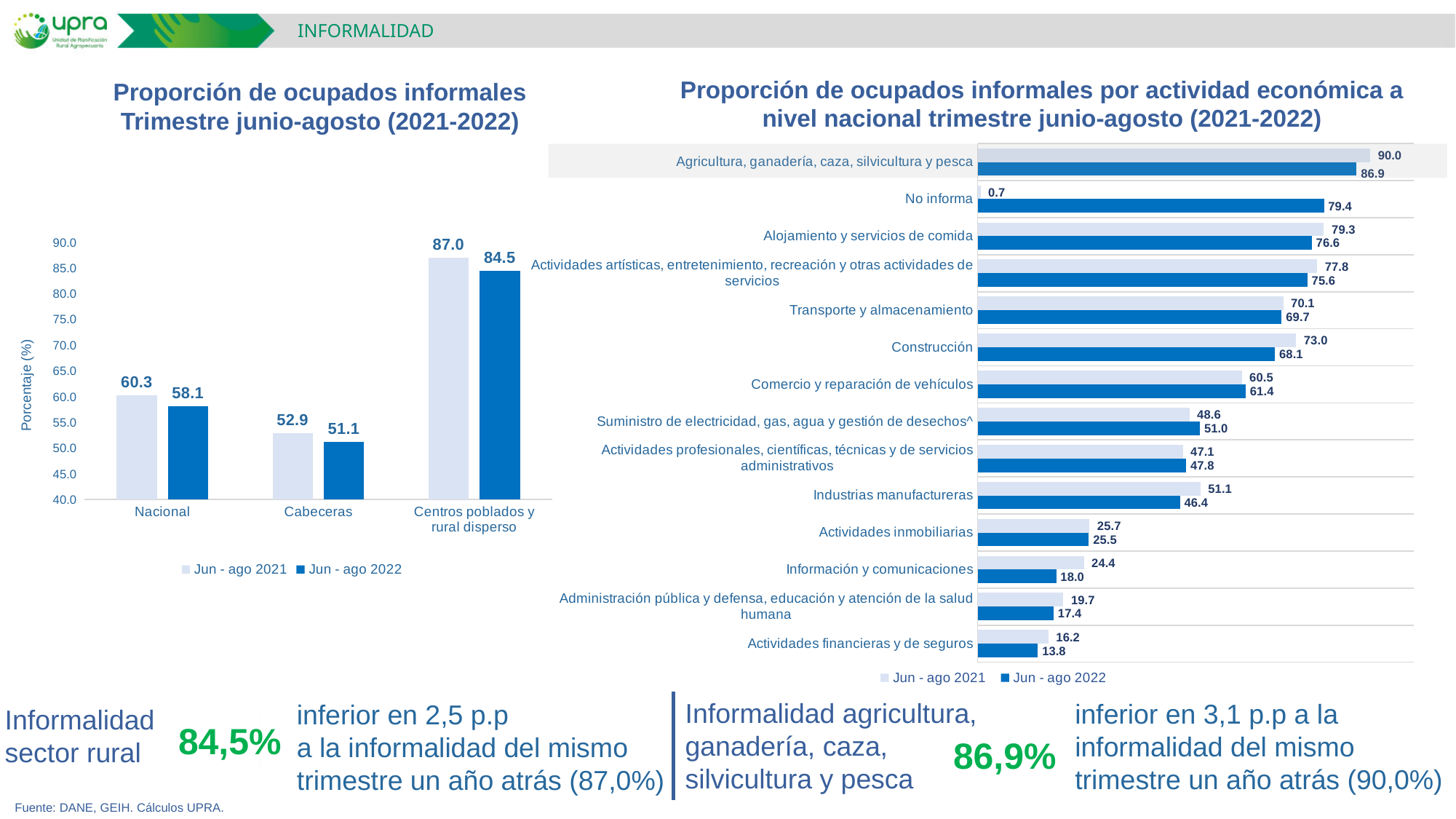
In the left chart (Proporción de ocupados informales, Trimestre junio-agosto), what is the difference between the Jun - ago 2021 and Jun - ago 2022 values for Centros poblados y rural disperso? 2.5 In the left chart (Proporción de ocupados informales, Trimestre junio-agosto), what type of chart is it? Bar chart In the right chart (Proporción de ocupados informales por actividad económica), which activity has the lowest Jun - ago 2022 value? Actividades financieras y de seguros In the right chart (Proporción de ocupados informales por actividad económica), how many series does the legend list? 2 In the left chart (Proporción de ocupados informales, Trimestre junio-agosto), what is the value for Cabeceras in Jun - ago 2021? 52.9 In the left chart (Proporción de ocupados informales, Trimestre junio-agosto), which category has the highest value in Jun - ago 2022? Centros poblados y rural disperso In the left chart (Proporción de ocupados informales, Trimestre junio-agosto), what is the value for Nacional in Jun - ago 2022? 58.1 In the right chart (Proporción de ocupados informales por actividad económica), how many economic activities are listed? 14 In the left chart (Proporción de ocupados informales, Trimestre junio-agosto), how many categories are shown on the x axis? 3 In the right chart (Proporción de ocupados informales por actividad económica), what is the Jun - ago 2021 value for No informa? 0.7 In the right chart (Proporción de ocupados informales por actividad económica), which is larger for Comercio y reparación de vehículos: the Jun - ago 2021 value or the Jun - ago 2022 value? Jun - ago 2022 In the right chart (Proporción de ocupados informales por actividad económica), what is the Jun - ago 2022 value for Construcción? 68.1